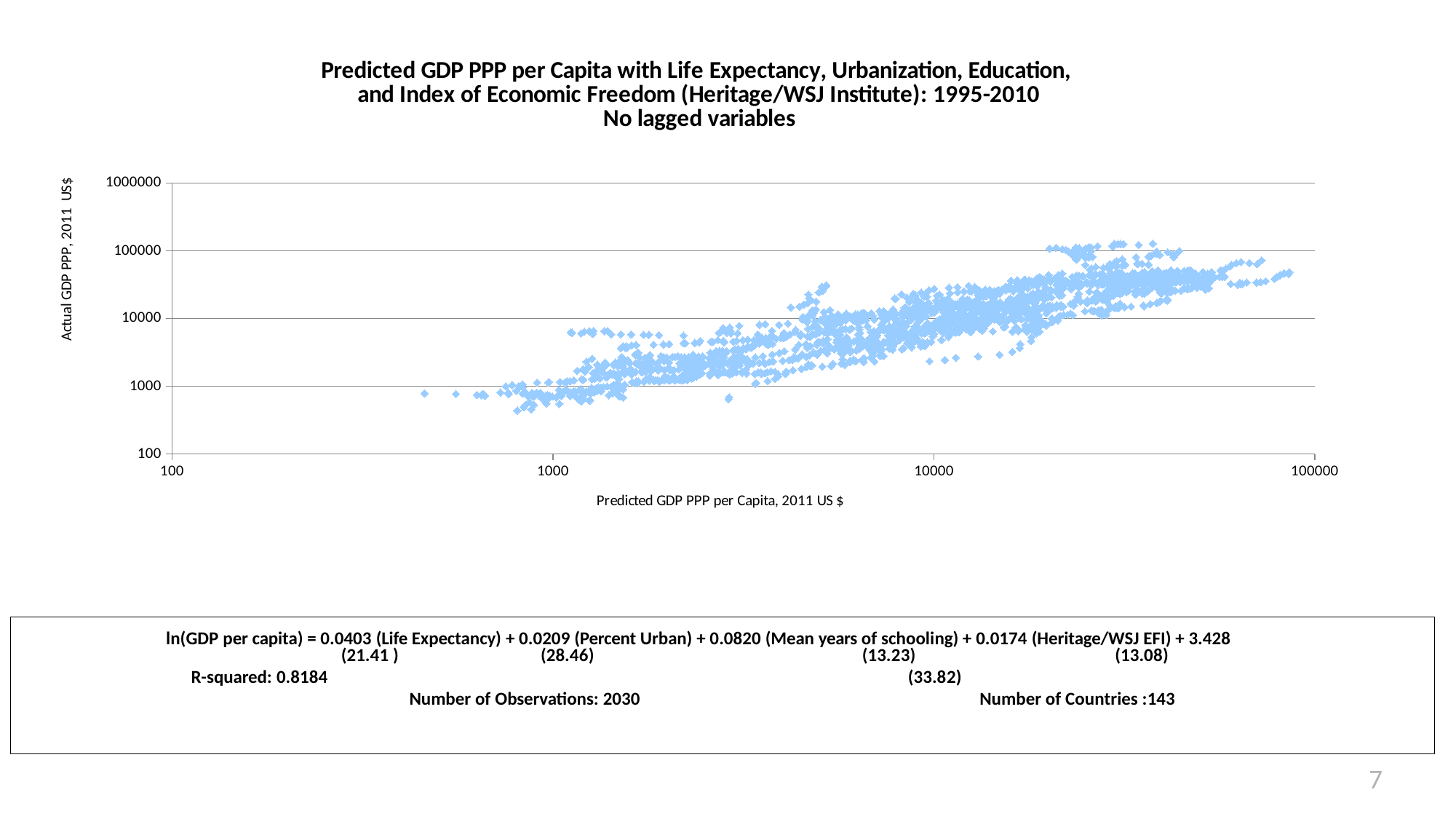
What is the label of the x axis of the chart? Predicted GDP PPP per Capita, 2011 US $ Is the predicted GDP PPP per capita of the leftmost point in the chart greater or less than 1000? less What kind of chart is shown on the slide? scatter plot What is the label of the y axis of the chart? Actual GDP PPP, 2011 US$ Is the actual GDP PPP of the lowest point in the chart greater or less than 1000? less As predicted GDP PPP per capita increases along the x axis, do the actual GDP PPP values generally rise or fall? rise